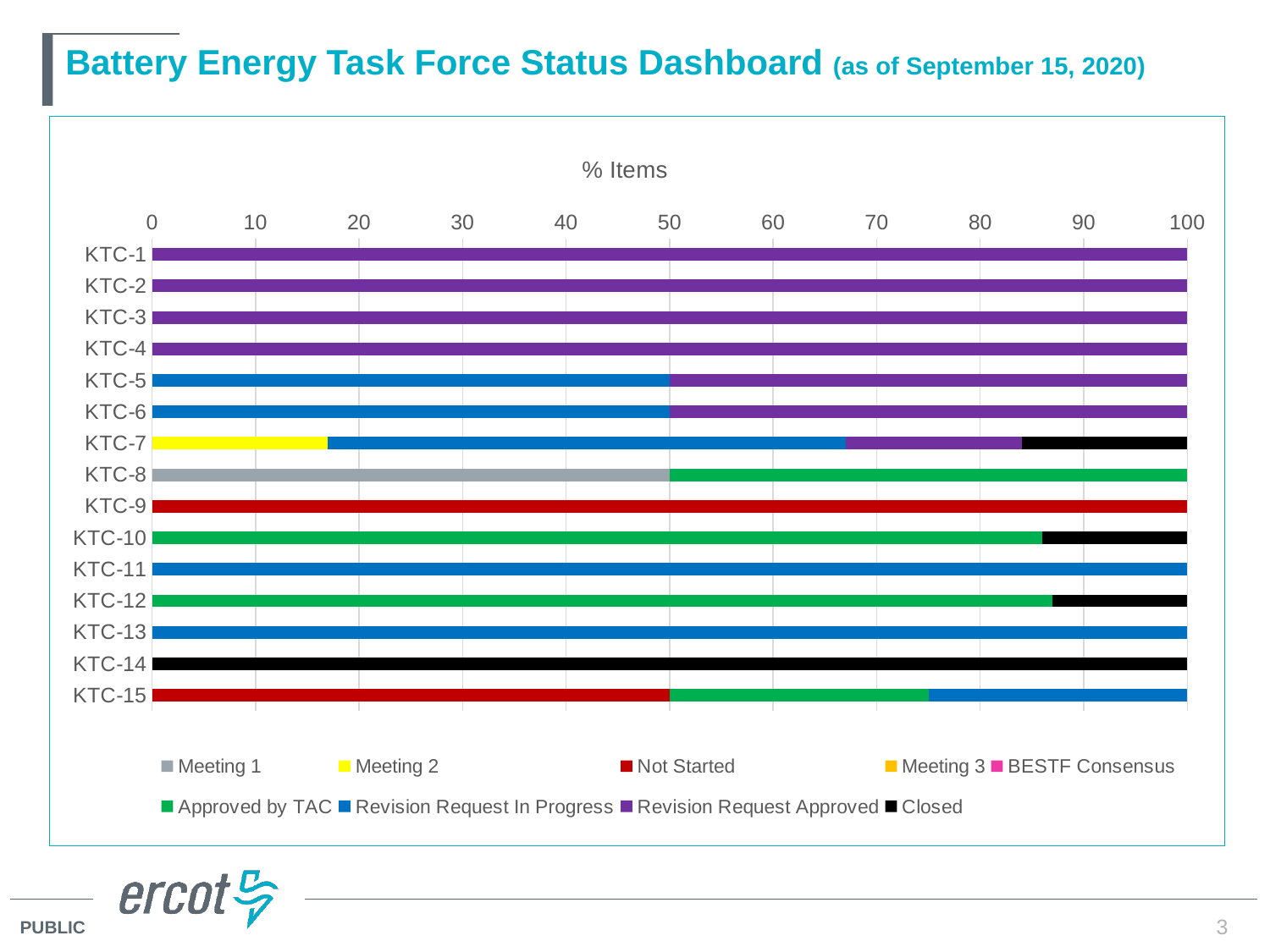
What is the Revision Request Approved value for KTC-1? 100 What is the Not Started value for KTC-15? 50 How many KTC categories are plotted on the chart? 15 Which series is shown in black in the legend? Closed What is the total of the stacked bar for KTC-7? 100 Is the Approved by TAC value for KTC-10 greater or less than 80? greater How many series does the legend list? 9 What is the Revision Request In Progress value for KTC-5? 50 What is the Meeting 1 value for KTC-8? 50 What kind of chart is shown on the slide? Stacked bar chart Is the Meeting 2 value for KTC-7 greater or less than 20? less What is the title of the chart? % Items